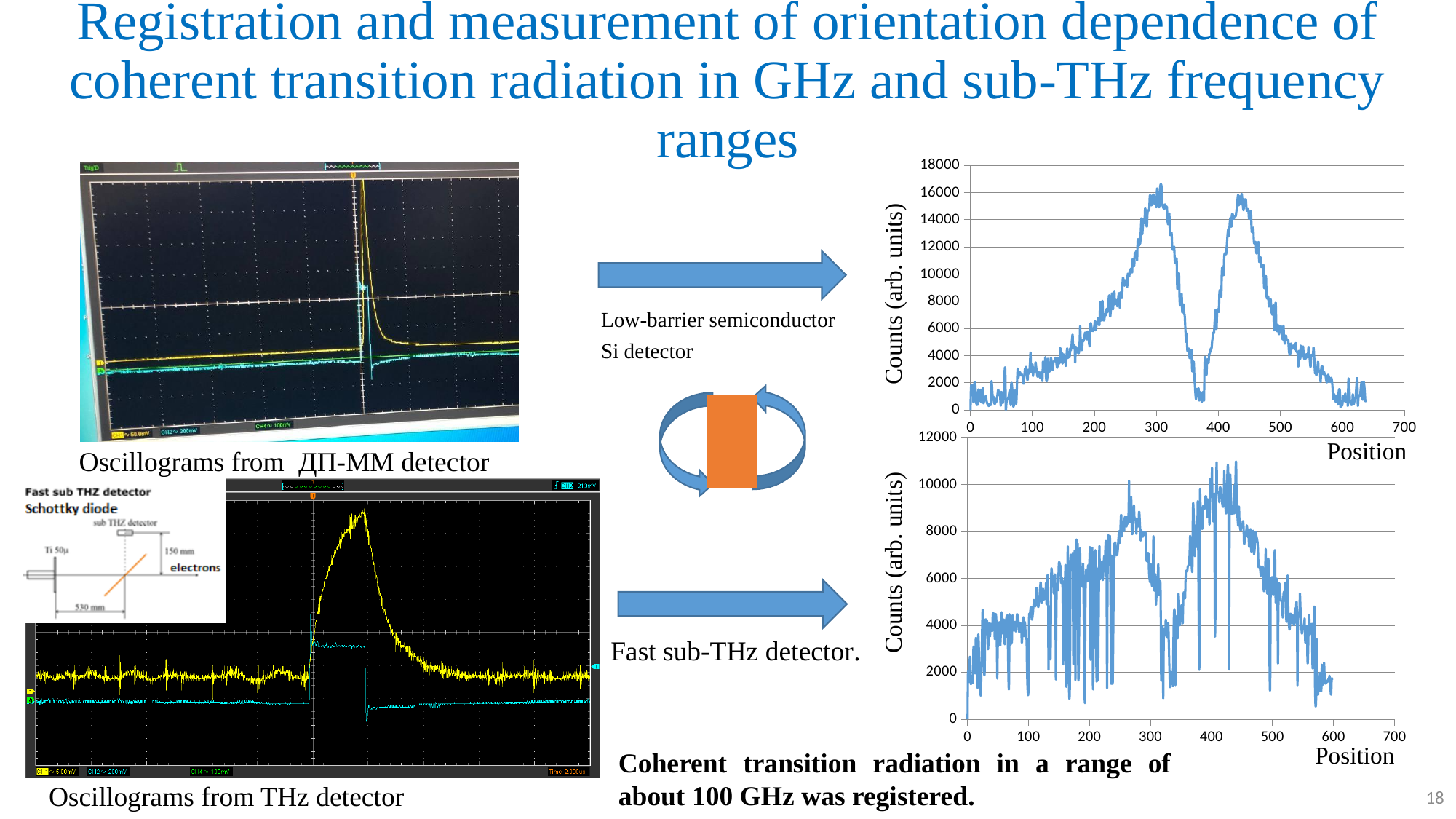
What kind of chart is the upper chart on the right side of the slide? line chart What is the x-axis label of the lower chart on the right? Position In the lower chart on the right, do the values rise or fall as position increases from 0 to 100? rise In the upper chart on the right, is the value at position 300 greater or less than 14000? greater In the lower chart on the right, is the value at position 420 greater or less than 8000? greater In the upper chart on the right, do the values rise or fall as position increases from 450 to 600? fall In the upper chart on the right, which is larger: the value at position 300 or the value at position 370? position 300 In the upper chart on the right, is the value at position 370 greater or less than 4000? less In the lower chart on the right, which is larger: the value at position 420 or the value at position 600? position 420 What is the y-axis label of the upper chart on the right? Counts (arb. units) What is the highest tick value shown on the y-axis of the lower chart on the right? 12000